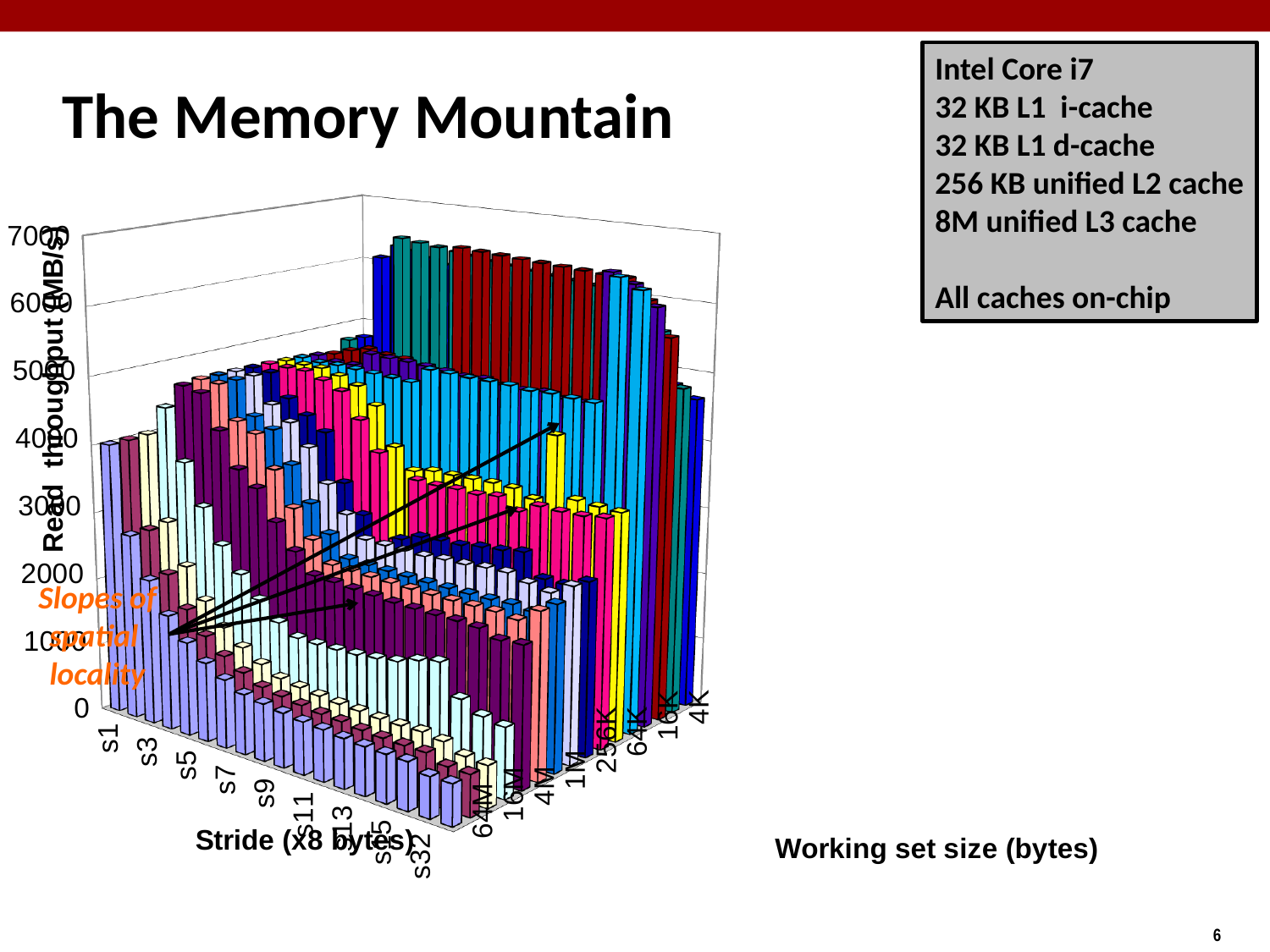
What is the first stride label shown on the stride axis? s1 What is the highest tick value shown on the vertical axis of the chart? 7000 What is the label of the depth axis of the chart? Working set size (bytes) What kind of chart is shown on the slide? bar chart For a fixed working set size, does read throughput rise or fall as the stride increases from s1 to s32? fall Is the tallest bar on the chart greater or less than 5000 MB/s? greater Does read throughput rise or fall as the working set size decreases from 64M toward 4K? rise